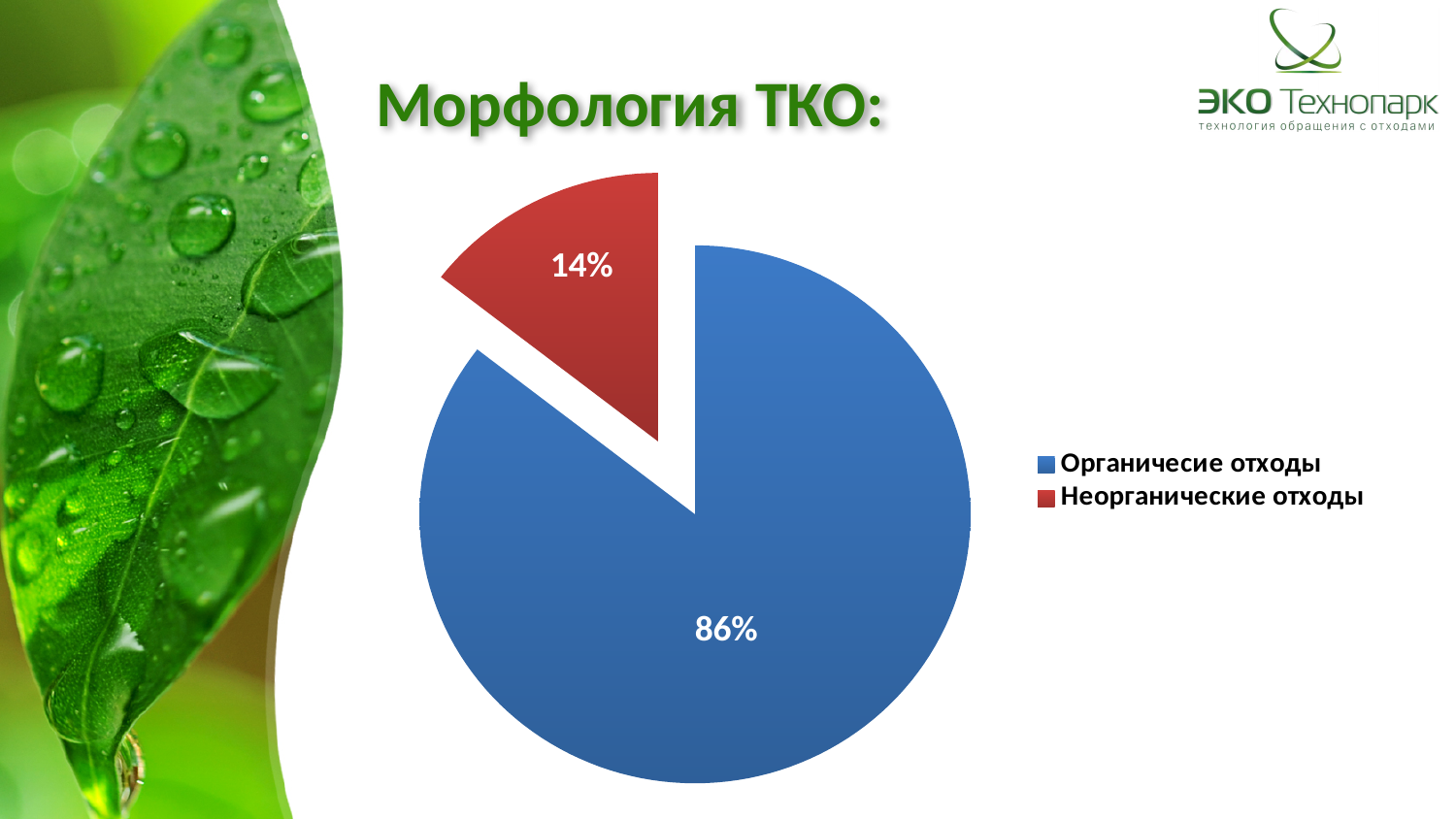
What colour is the slice for Неорганические отходы? Red Which category has the smallest slice of the pie? Неорганические отходы Which category has the largest slice of the pie? Органичесие отходы What kind of chart is shown on the slide? Pie chart How many entries does the legend list? 2 What share of the pie is labelled Неорганические отходы? 14% What is the difference in percentage points between Органичесие отходы and Неорганические отходы? 72 How many slices does the pie chart have? 2 What share of the pie is labelled Органичесие отходы? 86% Which is larger: the slice for Органичесие отходы or the slice for Неорганические отходы? Органичесие отходы What is the title of the slide containing the chart? Морфология ТКО: